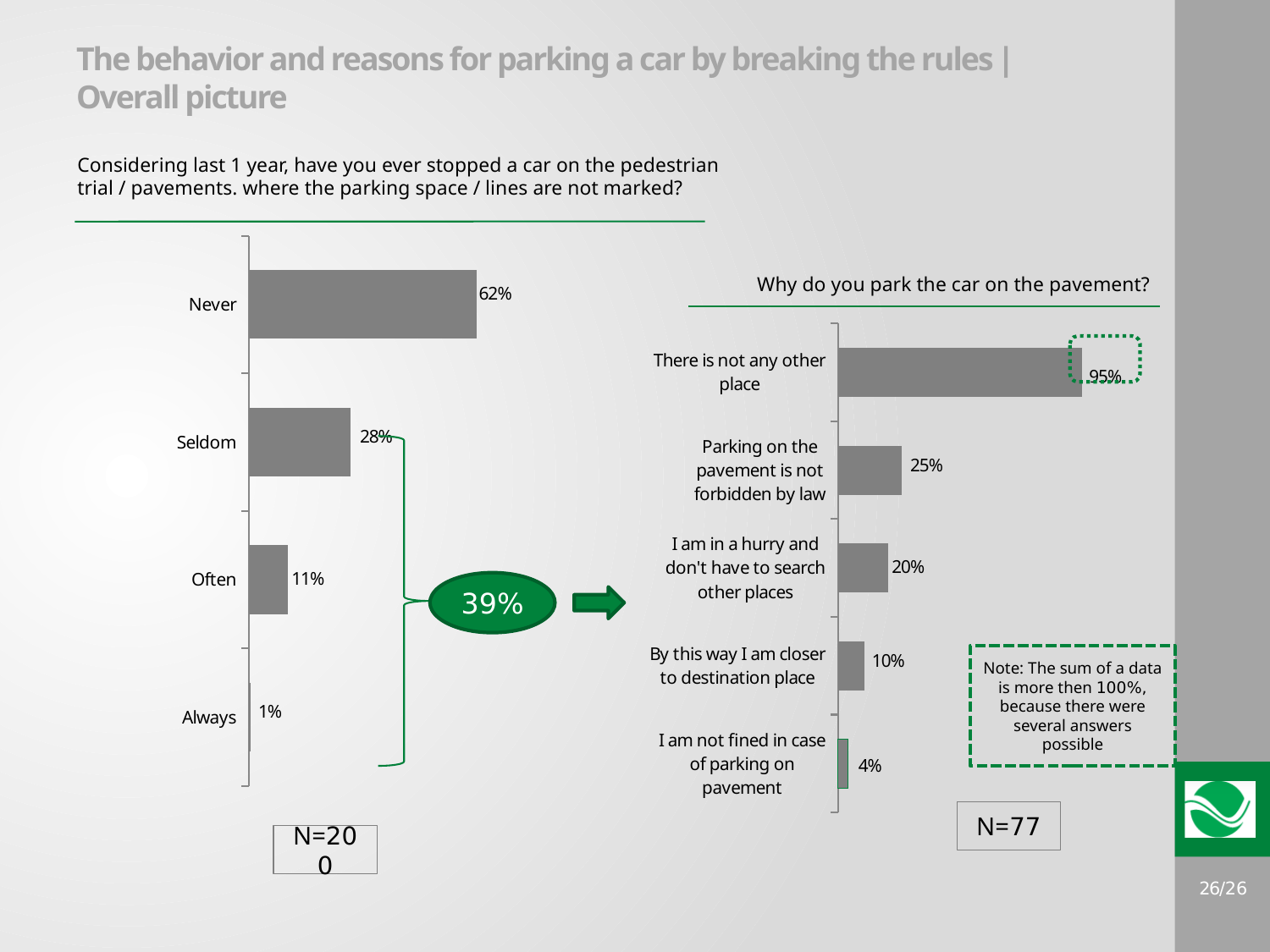
In the left chart, what percentage of respondents answered "Seldom"? 28% In the chart titled "Why do you park the car on the pavement?", what is the value for "There is not any other place"? 95% What type of chart is the chart titled "Why do you park the car on the pavement?"? Bar chart In the chart titled "Why do you park the car on the pavement?", what is the difference between the values for "Parking on the pavement is not forbidden by law" and "I am in a hurry and don't have to search other places"? 5% What is the sample size (N) shown below the chart titled "Why do you park the car on the pavement?"? N=77 In the chart titled "Why do you park the car on the pavement?", what is the value for "I am not fined in case of parking on pavement"? 4% In the chart titled "Why do you park the car on the pavement?", which is larger: "Parking on the pavement is not forbidden by law" or "By this way I am closer to destination place"? Parking on the pavement is not forbidden by law In the left chart, what percentage of respondents answered "Never"? 62% In the left chart, how many categories are shown? 4 In the chart titled "Why do you park the car on the pavement?", which reason has the highest value? There is not any other place In the left chart, which category has the lowest value? Always In the left chart, what is the difference between the values for "Never" and "Seldom"? 34%